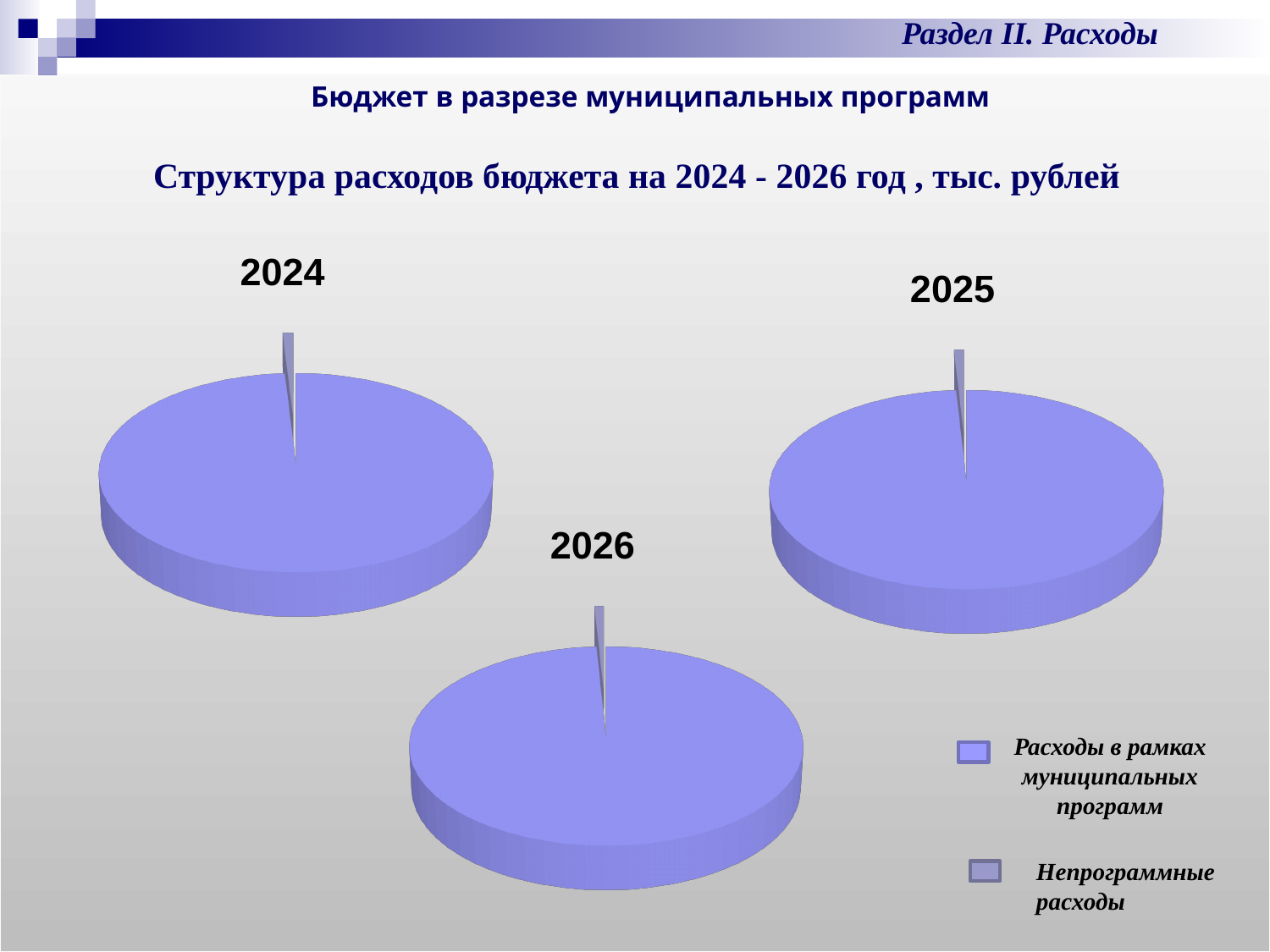
How many entries does the legend list? 2 How many pie charts are shown on the slide? 3 In the 2024 pie chart, which category has the largest slice? Расходы в рамках муниципальных программ In the 2025 pie chart, which category has the largest slice? Расходы в рамках муниципальных программ What unit is stated in the chart title for the budget expenditure structure? тыс. рублей In the 2024 pie chart, which category has the smallest slice? Непрограммные расходы How many slices does each pie chart have? 2 In the 2025 pie chart, which category has the smallest slice? Непрограммные расходы Which years are the three pie charts labelled with? 2024, 2025, 2026 In the 2026 pie chart, which is larger: Расходы в рамках муниципальных программ or Непрограммные расходы? Расходы в рамках муниципальных программ What kind of chart is used for the 2024 chart? pie chart